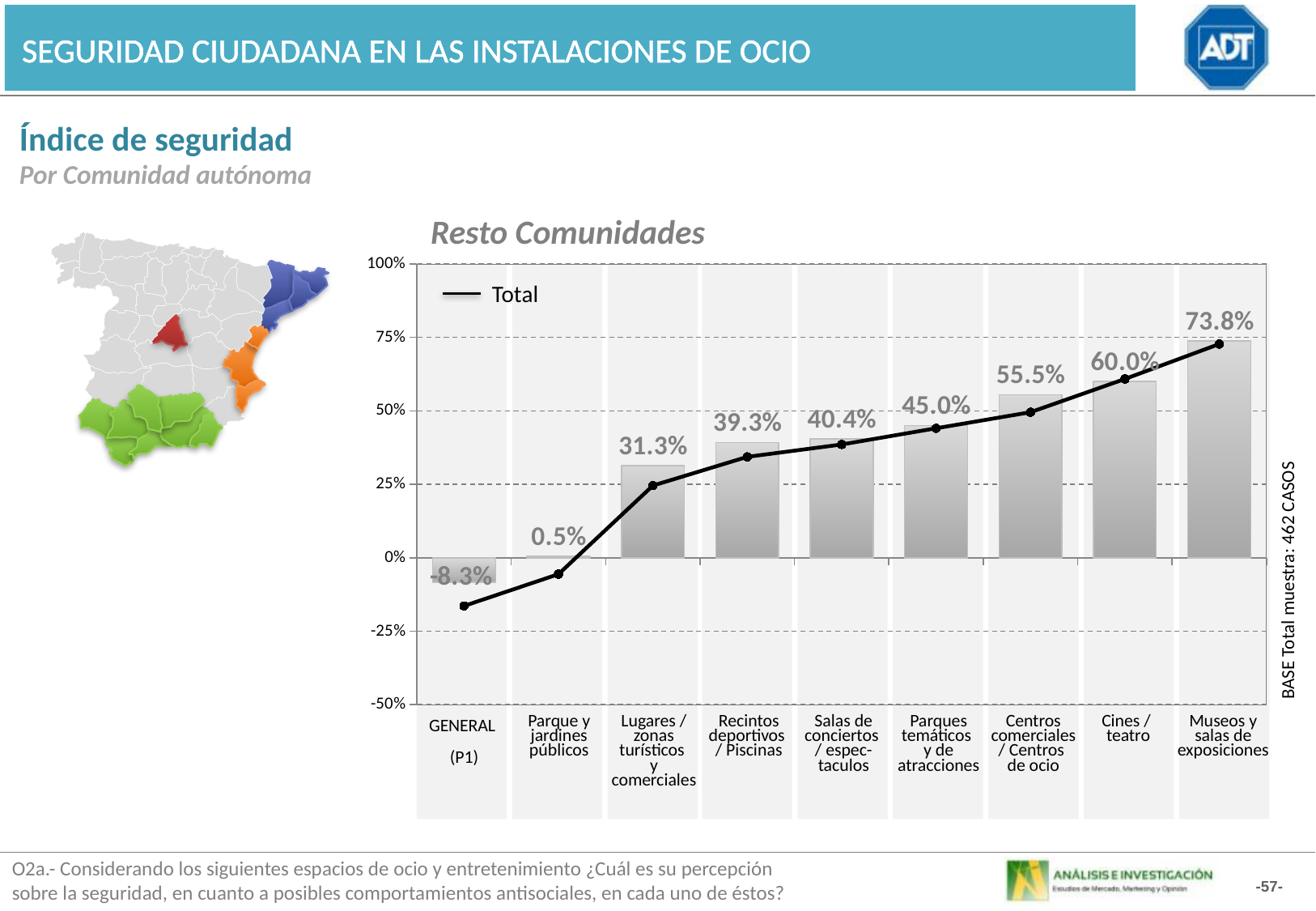
What is the value shown for Parques temáticos y de atracciones? 45.0% What is the difference between the values for Museos y salas de exposiciones and Cines / teatro? 13.8% How many series does the legend of the Resto Comunidades chart list? 1 Which category has the highest bar value in the Resto Comunidades chart? Museos y salas de exposiciones What is the difference between the values for Centros comerciales / Centros de ocio and Parques temáticos y de atracciones? 10.5% How many categories are shown on the x axis of the Resto Comunidades chart? 9 Is the Total line value for GENERAL (P1) greater or less than 0%? less Which has a larger value, Recintos deportivos / Piscinas or Lugares / zonas turísticos y comerciales? Recintos deportivos / Piscinas Which category has the lowest bar value in the Resto Comunidades chart? GENERAL (P1) What is the value shown for GENERAL (P1) in the Resto Comunidades chart? -8.3% What is the value shown for Cines / teatro? 60.0% What is the value shown for Museos y salas de exposiciones in the Resto Comunidades chart? 73.8%